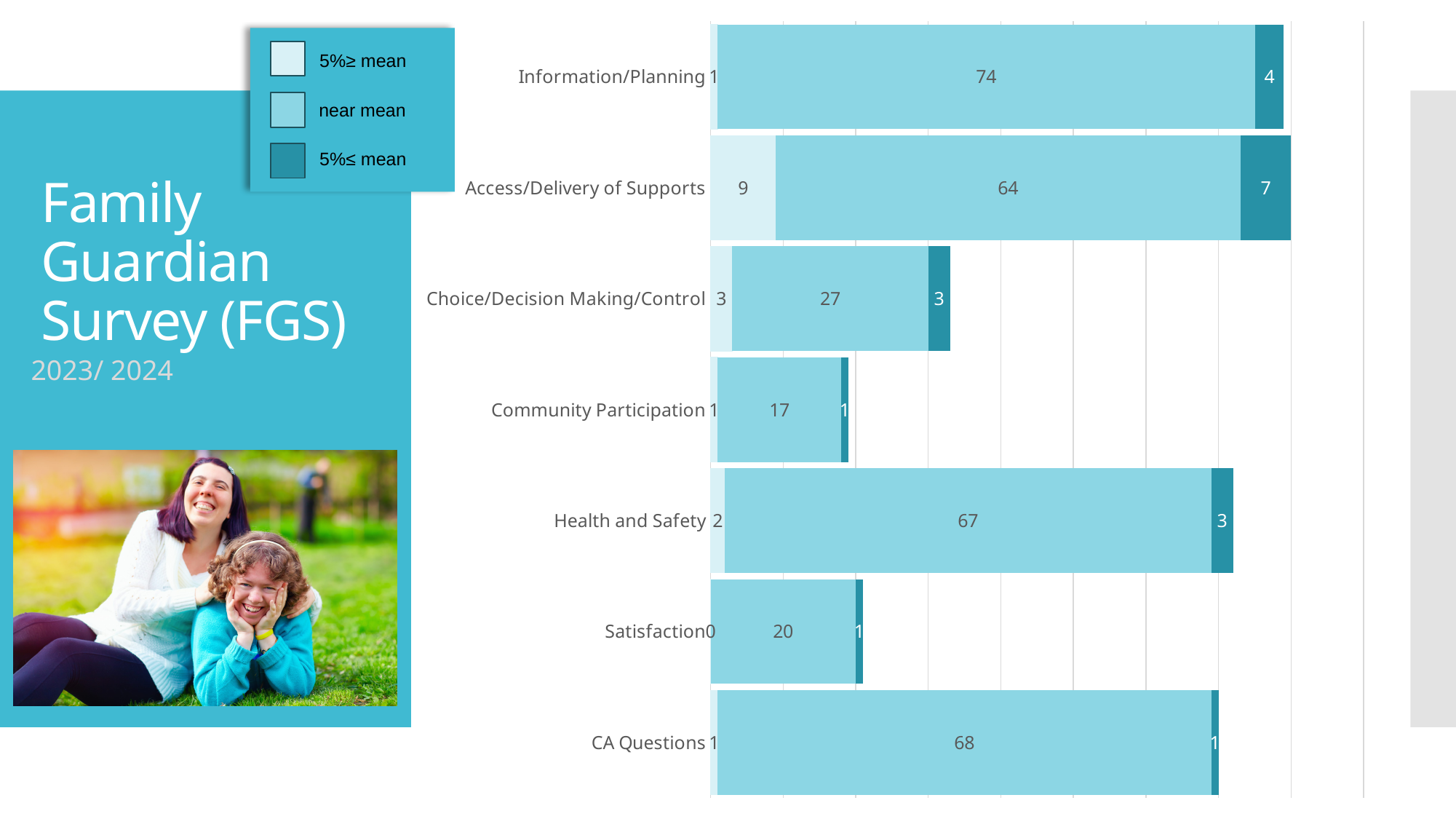
What is the "5%≤ mean" value for Health and Safety? 3 What is the "near mean" value for Satisfaction? 20 What is the "5%≥ mean" value for Access/Delivery of Supports? 9 What is the "near mean" value for Information/Planning? 74 What is the total of the stacked bar for Access/Delivery of Supports? 80 What is the difference between the "near mean" values for Health and Safety and CA Questions? 1 How many series does the legend list? 3 Which category has the lowest "near mean" value? Community Participation Which has a larger "5%≤ mean" value, Access/Delivery of Supports or Information/Planning? Access/Delivery of Supports Which category has the highest "near mean" value? Information/Planning How many categories are shown on the chart? 7 What is the total of the stacked bar for Choice/Decision Making/Control? 33